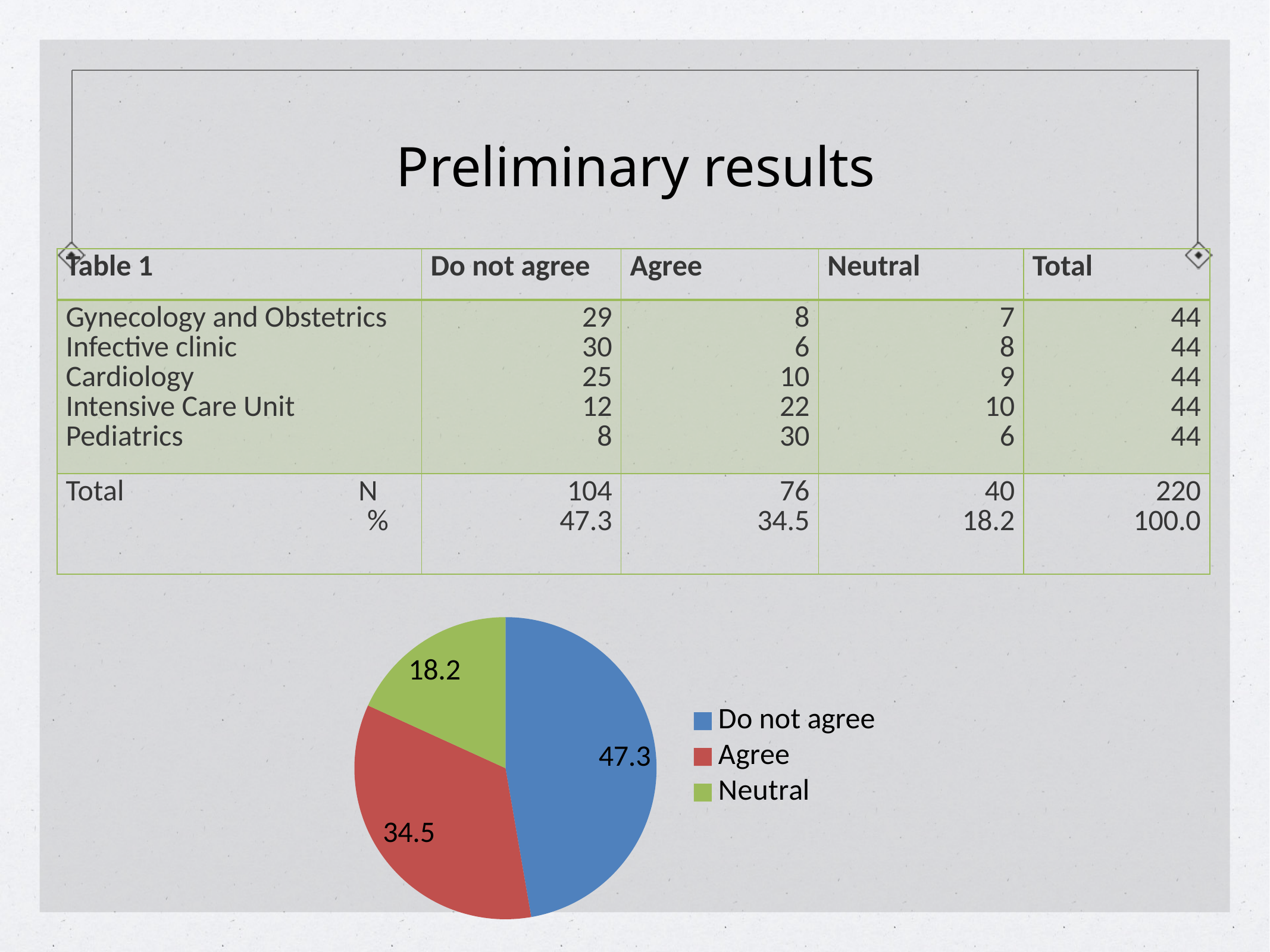
What is the value of the 'Agree' slice in the pie chart? 34.5 Which is larger in the pie chart, 'Agree' or 'Neutral'? Agree What is the difference between the 'Agree' and 'Neutral' values in the pie chart? 16.3 Which slice of the pie chart is the largest? Do not agree What is the value of the 'Do not agree' slice in the pie chart? 47.3 What is the difference between the 'Do not agree' and 'Agree' values in the pie chart? 12.8 How many slices does the pie chart have? 3 How many entries does the pie chart legend list? 3 What is the value of the 'Neutral' slice in the pie chart? 18.2 Which slice of the pie chart is the smallest? Neutral What colour is the 'Agree' slice in the pie chart? red What kind of chart is shown on the slide? pie chart